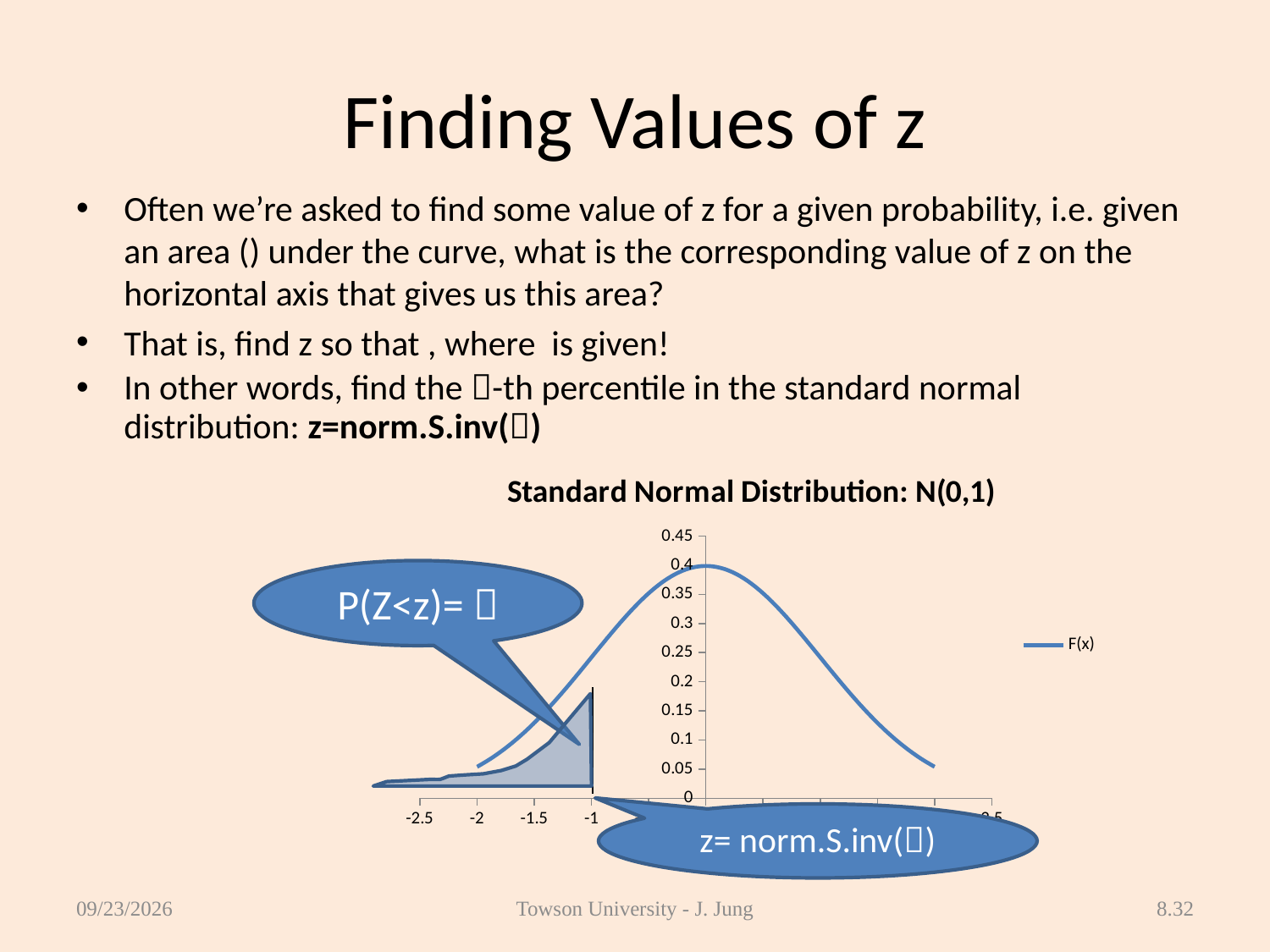
Does the F(x) curve rise or fall as x increases from -2.5 to -1? rise What kind of chart is shown on the slide? line chart What is the title of the chart? Standard Normal Distribution: N(0,1) What is the highest value shown on the vertical axis of the chart? 0.45 What is the name of the series shown in the chart legend? F(x) Is the value of F(x) at x = -1 greater or less than 0.3? less Is the peak value of the F(x) curve greater or less than 0.35? greater Which is larger, the value of F(x) at x = -1 or at x = -2? x = -1 Does the F(x) curve rise or fall along the right half of the x axis, after its peak? fall How many series does the chart legend list? 1 Is the value of F(x) at x = -1 greater or less than 0.2? greater